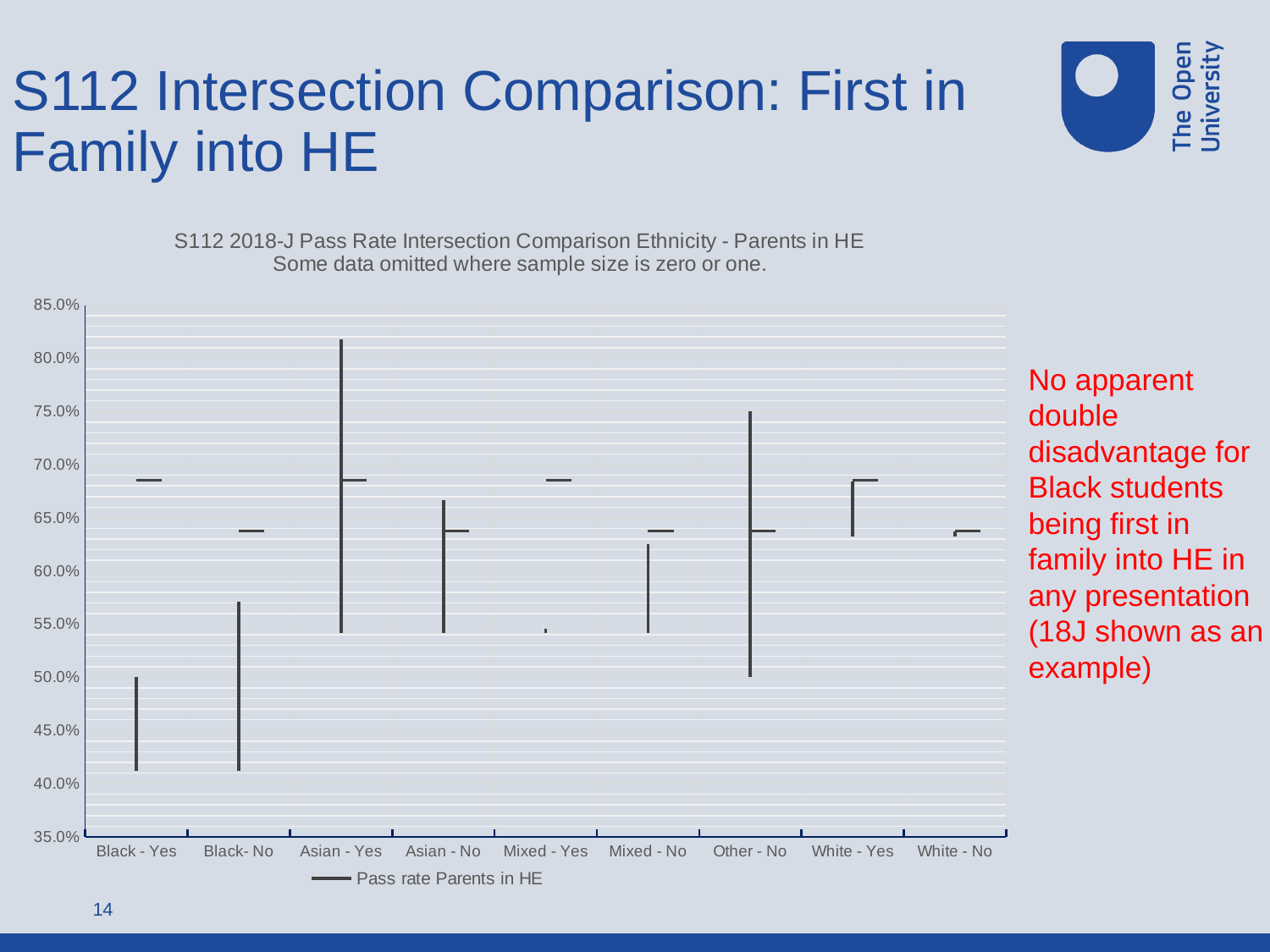
What is the first line of the chart's title? S112 2018-J Pass Rate Intersection Comparison Ethnicity - Parents in HE Is the top of the line for Mixed - No greater or less than 60.0%? greater Which category's line reaches the highest point on the chart? Asian - Yes Is the bottom of the line for Asian - Yes greater or less than 60.0%? less How many series does the chart legend list? 1 How many categories are shown on the x axis of the chart? 9 Is the top of the line for Asian - Yes greater or less than 80.0%? greater Which category is the last one on the x axis? White - No What is the name of the series shown in the chart legend? Pass rate Parents in HE